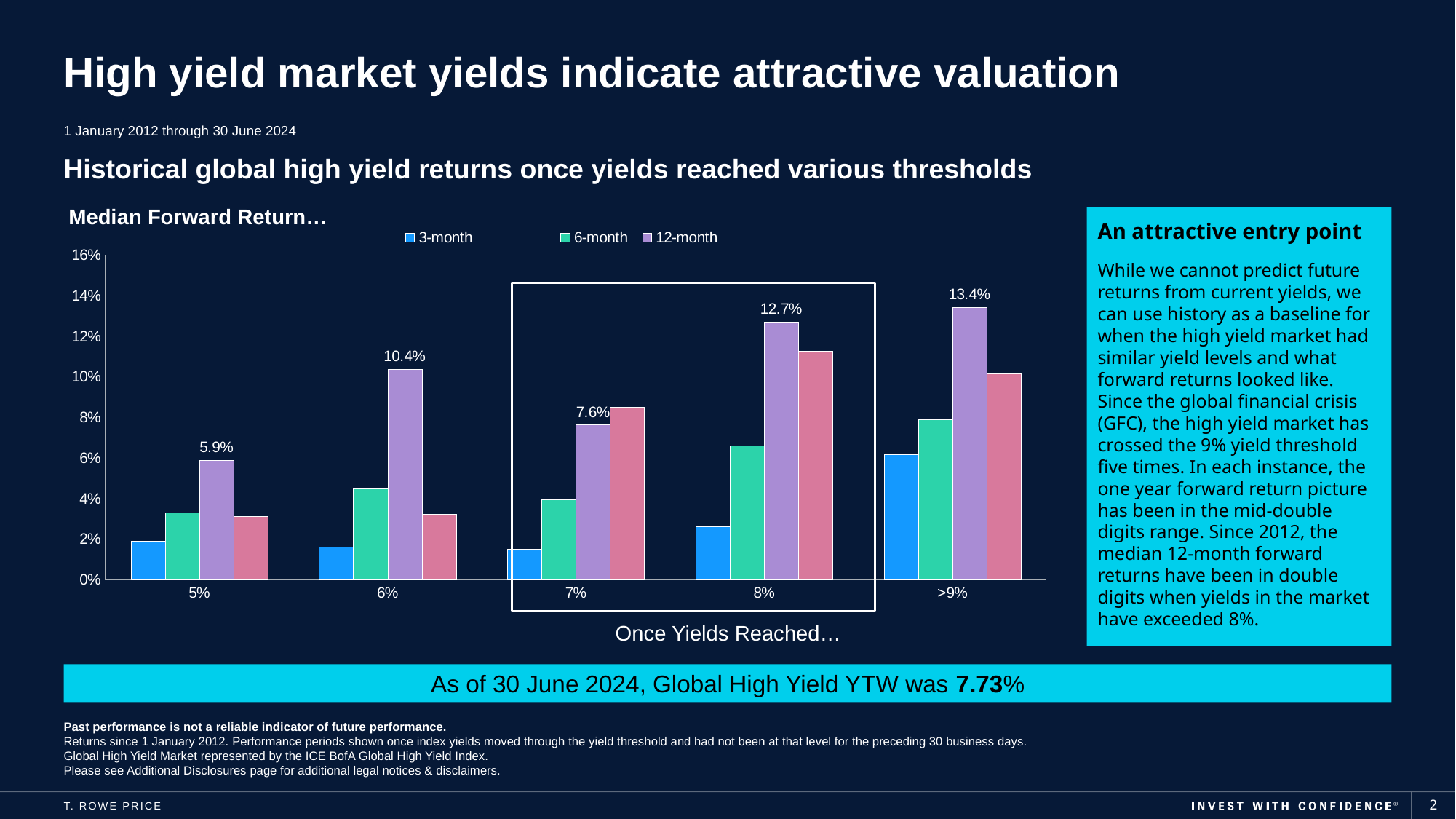
What is the median 12-month forward return once yields reached >9%? 13.4% What is the median 12-month forward return once yields reached 8%? 12.7% What is the median 12-month forward return once yields reached 7%? 7.6% How many yield threshold categories are shown on the x axis? 5 What is the difference between the 12-month forward return at 6% and at 5%? 4.5% Which yield threshold has the highest 12-month median forward return? >9% What is the median 12-month forward return once yields reached 5%? 5.9% What kind of chart is shown on the slide? Bar chart Which is larger, the 12-month forward return at 6% or at 7%? 6% Which yield threshold has the lowest 12-month median forward return? 5% Is the 3-month forward return at the 5% threshold greater or less than 4%? less How many series does the legend list? 3